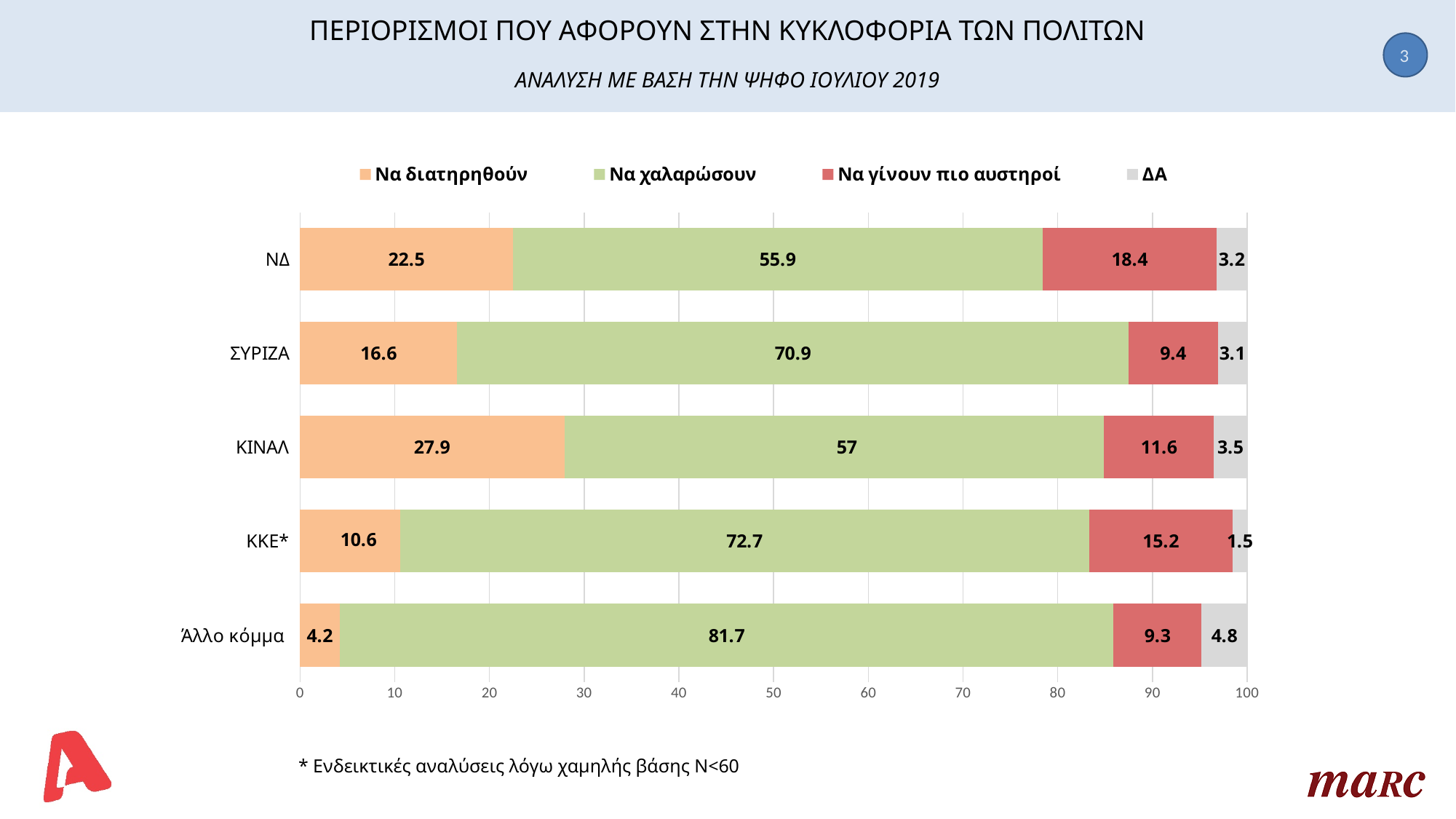
What is the 'ΔΑ' value for Άλλο κόμμα? 4.8 Which is larger: the 'Να διατηρηθούν' value for ΝΔ or for ΣΥΡΙΖΑ? ΝΔ What is the total of the stacked bar for ΚΚΕ*? 100 What is the value of 'Να χαλαρώσουν' for ΣΥΡΙΖΑ? 70.9 What is the difference between the 'Να γίνουν πιο αυστηροί' values for ΝΔ and ΣΥΡΙΖΑ? 9 Which party has the lowest value for 'Να διατηρηθούν'? Άλλο κόμμα What kind of chart is shown on the slide? Stacked bar chart Which party has the highest value for 'Να χαλαρώσουν'? Άλλο κόμμα How many series does the legend list? 4 What is the value of 'Να γίνουν πιο αυστηροί' for ΚΚΕ*? 15.2 How many categories (parties) are shown on the chart? 5 What is the value of 'Να διατηρηθούν' for ΚΙΝΑΛ? 27.9